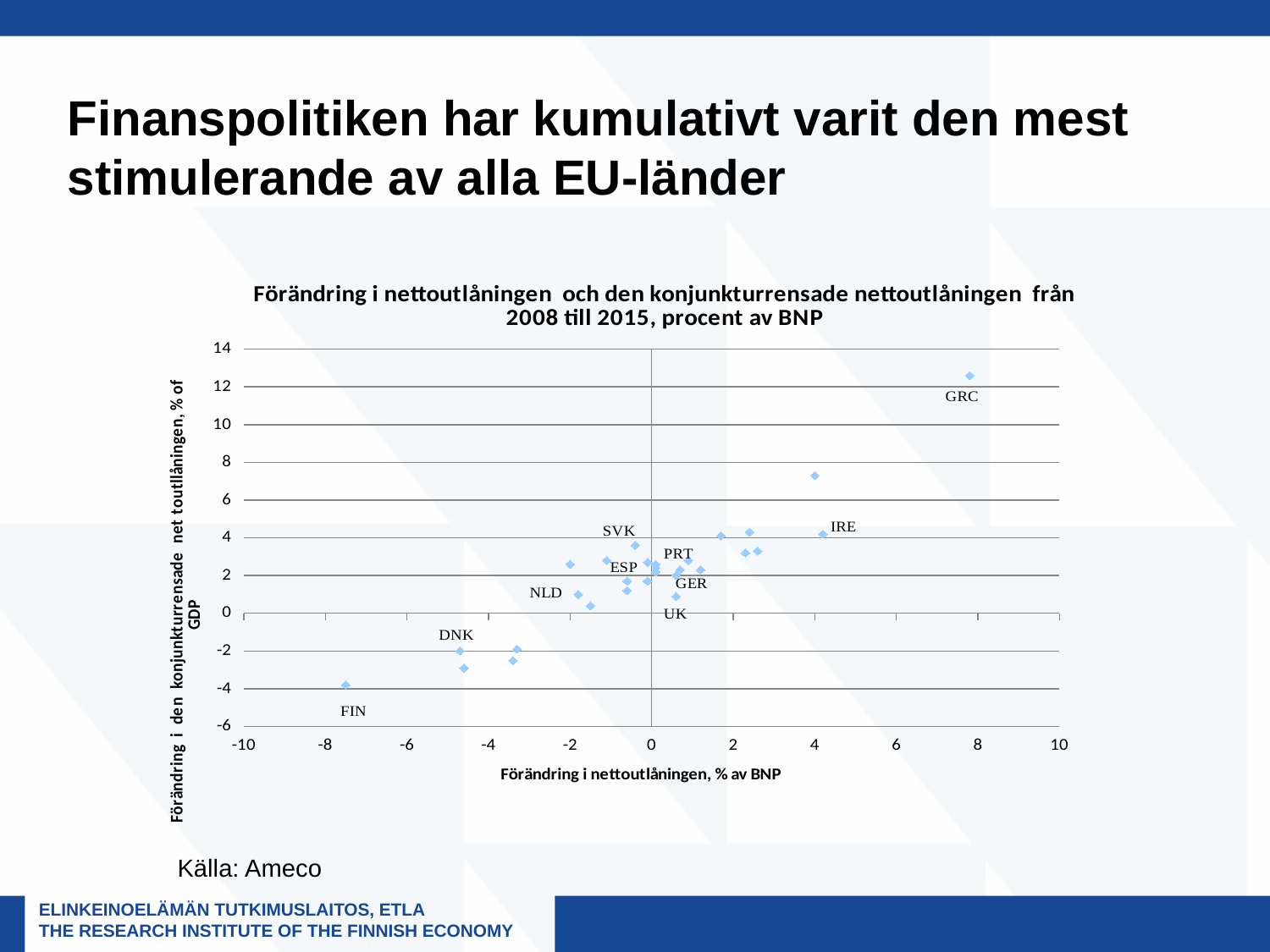
Is the vertical-axis value for DNK greater or less than 0? less Which labelled country is furthest to the left on the horizontal axis? FIN Is the horizontal-axis value for GRC greater or less than 6? greater Which has the higher vertical-axis value, IRE or UK? IRE Is the vertical-axis value for GRC greater or less than 10? greater What is the title of the horizontal axis? Förändring i nettoutlåningen, % av BNP Which labelled country has the highest value on the vertical axis? GRC Which labelled country has the lowest value on the vertical axis? FIN What kind of chart is shown on the slide? Scatter chart Which has the higher horizontal-axis value, DNK or FIN? DNK